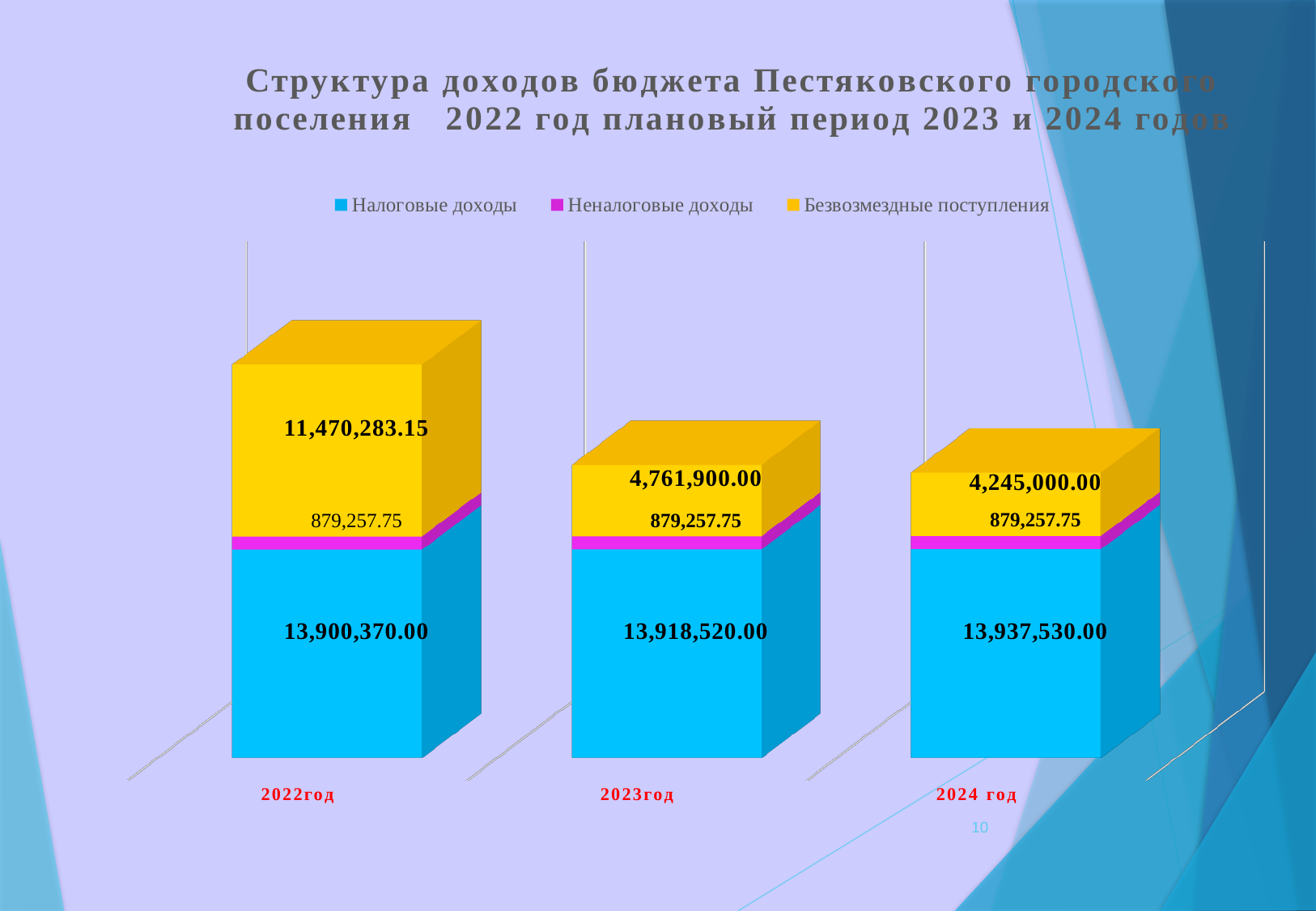
Which is larger: Налоговые доходы in 2022год or Безвозмездные поступления in 2022год? Налоговые доходы in 2022год What is the value of Налоговые доходы for 2022год? 13,900,370.00 What kind of chart is shown on the slide? Stacked bar chart What is the value of Безвозмездные поступления for 2024 год? 4,245,000.00 What is the difference between Безвозмездные поступления in 2022год and 2023год? 6,708,383.15 How many series does the legend list? 3 What is the total of the stacked bar for 2023год? 19,559,677.75 In which year is Безвозмездные поступления highest? 2022год What is the difference between Безвозмездные поступления in 2023год and 2024 год? 516,900.00 In which year is Безвозмездные поступления lowest? 2024 год What is the value of Безвозмездные поступления for 2023год? 4,761,900.00 What is the value of Неналоговые доходы for 2024 год? 879,257.75